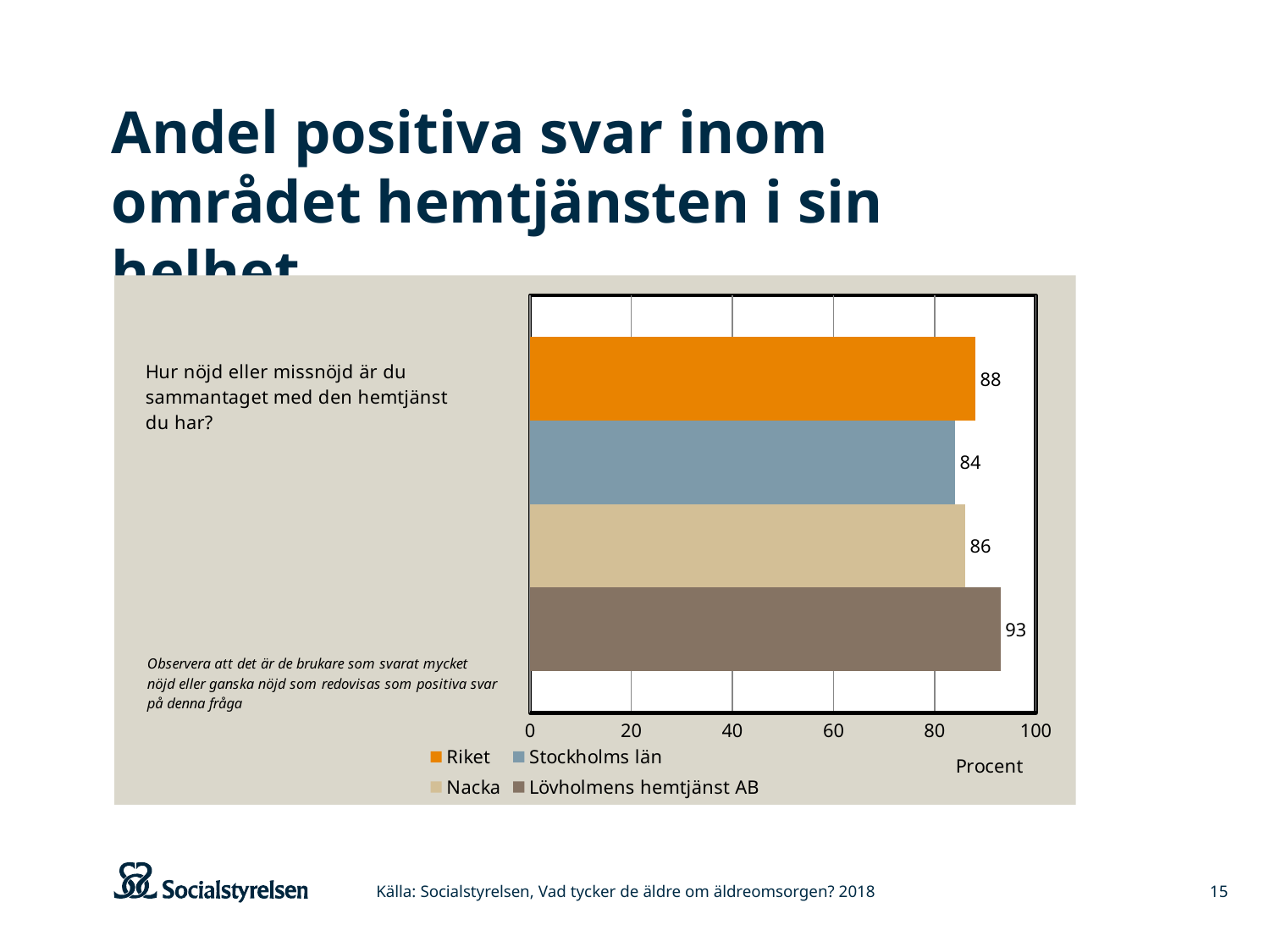
Is the value for Stockholms län greater or less than 80? greater How many series does the legend list? 4 What is the label on the horizontal axis of the chart? Procent Which is larger, the value for Nacka or the value for Stockholms län? Nacka What is the difference between the values for Lövholmens hemtjänst AB and Riket? 5 Which series has the lowest value? Stockholms län What value is shown for Riket? 88 What value is shown for Nacka? 86 What value is shown for Stockholms län? 84 What kind of chart is shown on the slide? Bar chart What value is shown for Lövholmens hemtjänst AB? 93 Which series has the highest value? Lövholmens hemtjänst AB